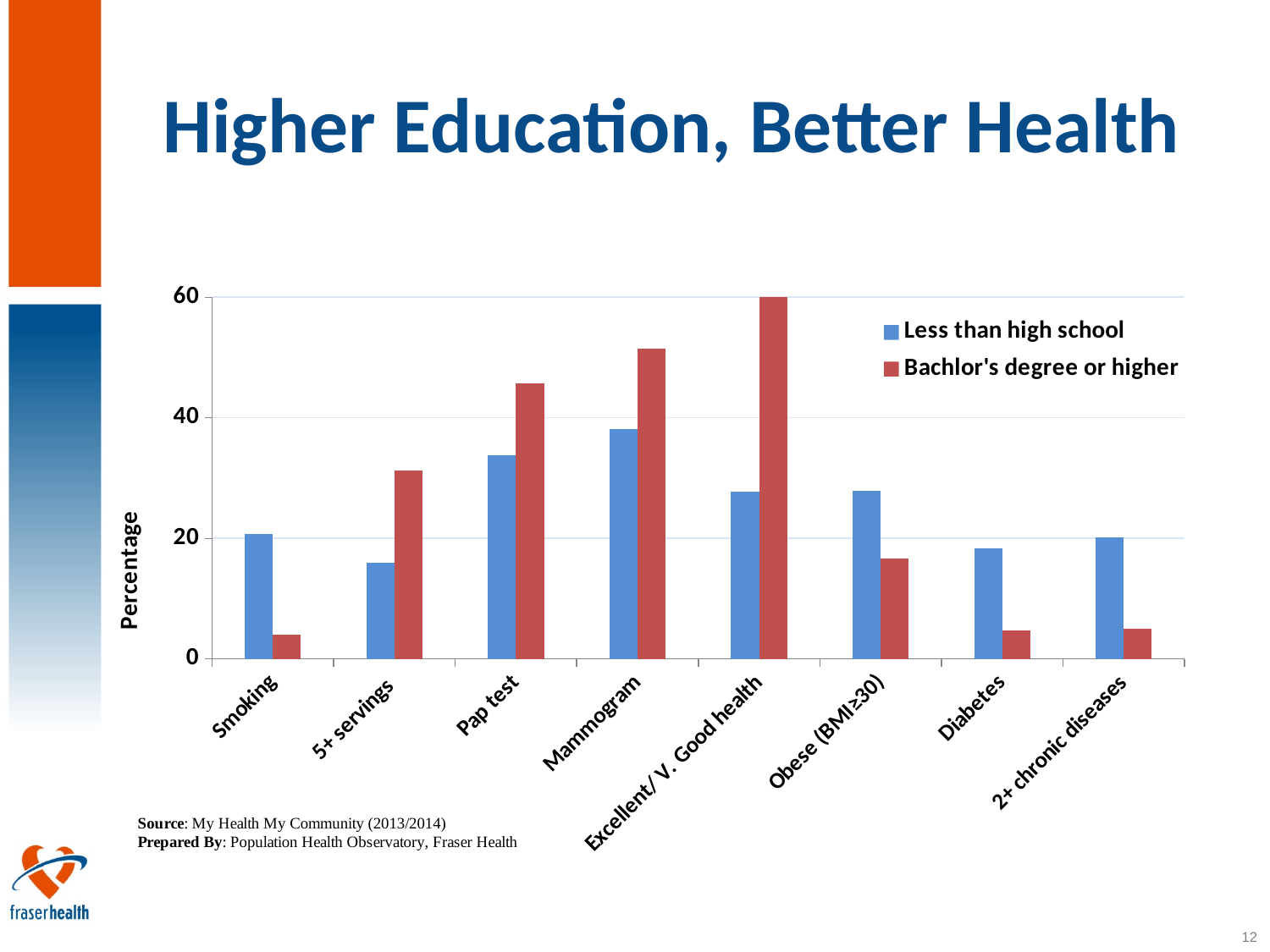
What kind of chart is shown on the slide? bar chart Which category has the highest value for the Less than high school series? Mammogram For 5+ servings, which series has the larger value: Less than high school or Bachlor's degree or higher? Bachlor's degree or higher Is the value for Smoking in the Less than high school series greater or less than 20? greater How many categories are shown on the x axis? 8 How many series does the legend list? 2 For Obese (BMI≥30), which series has the larger value: Less than high school or Bachlor's degree or higher? Less than high school Which category has the lowest value for the Bachlor's degree or higher series? Smoking What is the label on the y axis of the chart? Percentage Is the value for Pap test in the Bachlor's degree or higher series greater or less than 40? greater Which category has the highest value for the Bachlor's degree or higher series? Excellent/ V. Good health Is the value for Diabetes in the Less than high school series greater or less than 20? less